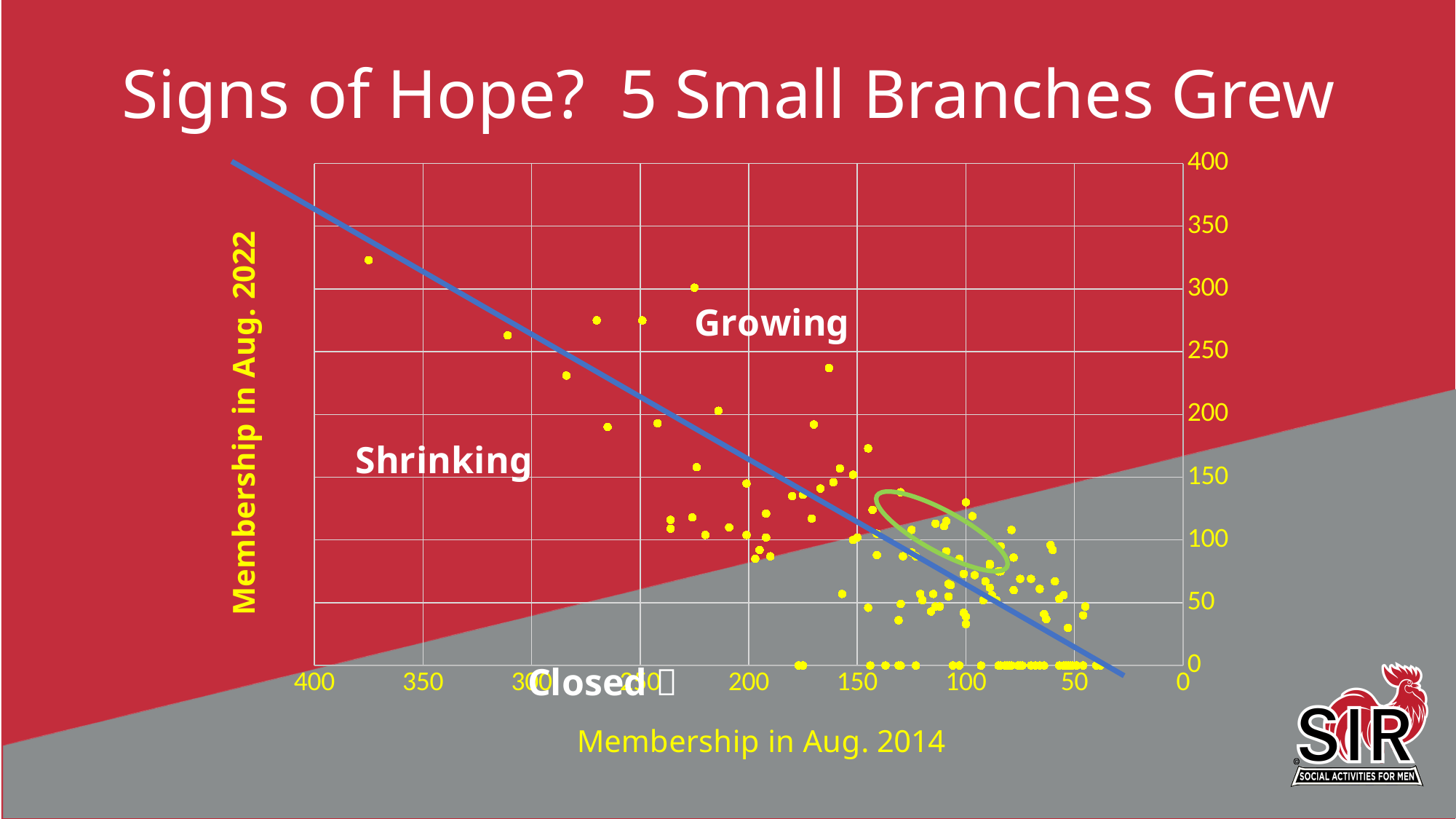
Moving from left to right along the horizontal axis, does the blue trend line rise or fall? fall What kind of chart is shown on the slide? scatter chart What is the title of the horizontal axis of the chart? Membership in Aug. 2014 Is the Aug. 2014 membership of the point with the highest Aug. 2022 membership greater or less than 350? greater What is the title of the vertical axis of the chart? Membership in Aug. 2022 Is the Aug. 2022 membership of the point with the highest Aug. 2014 membership greater or less than 350? less Is the Aug. 2022 membership of the highest plotted point greater or less than 300? greater